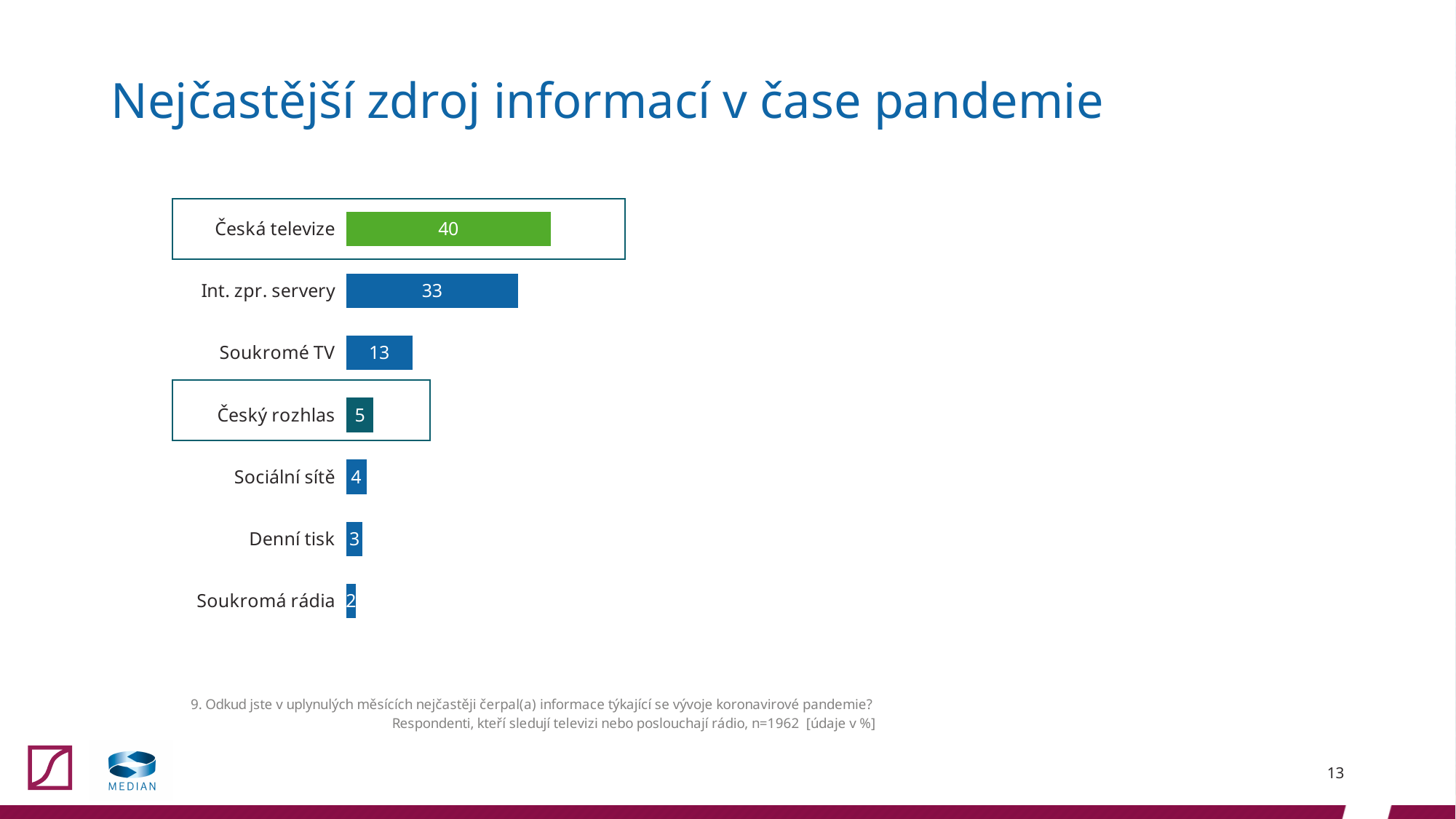
What is the difference between the values for Česká televize and Int. zpr. servery? 7 What kind of chart is shown on the slide? Bar chart Which is larger, the value for Sociální sítě or the value for Denní tisk? Sociální sítě Which bar is coloured green? Česká televize What is the value for Česká televize? 40 How many categories are shown in the chart? 7 What is the value for Int. zpr. servery? 33 What is the value for Soukromé TV? 13 Which category has the lowest value? Soukromá rádia Which category has the highest value? Česká televize What is the difference between the values for Soukromé TV and Český rozhlas? 8 What is the value for Český rozhlas? 5